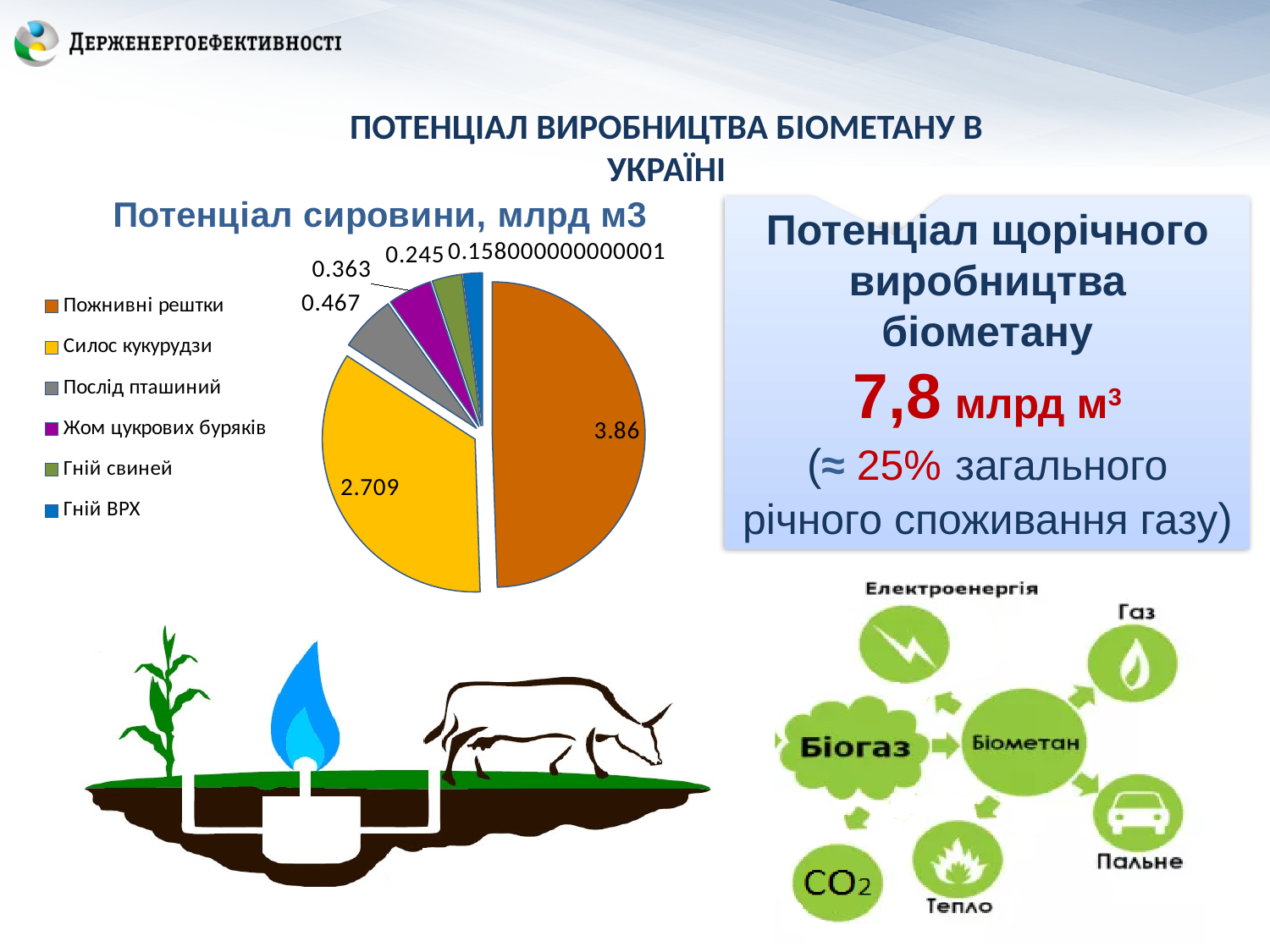
What is the value for Пожнивні рештки in the pie chart? 3.86 Which category has the largest slice in the pie chart? Пожнивні рештки What is the difference between the values for Пожнивні рештки and Силос кукурудзи in the pie chart? 1.151 What is the value for Гній свиней in the pie chart? 0.245 What is the value for Жом цукрових буряків in the pie chart? 0.363 Which is larger in the pie chart: Послід пташиний or Жом цукрових буряків? Послід пташиний Which category has the smallest slice in the pie chart? Гній ВРХ How many categories does the pie chart legend list? 6 What is the value for Силос кукурудзи in the pie chart? 2.709 What is the value for Послід пташиний in the pie chart? 0.467 What kind of chart is shown under the title "Потенціал сировини, млрд м3"? pie chart What colour is the slice for Силос кукурудзи in the pie chart? yellow